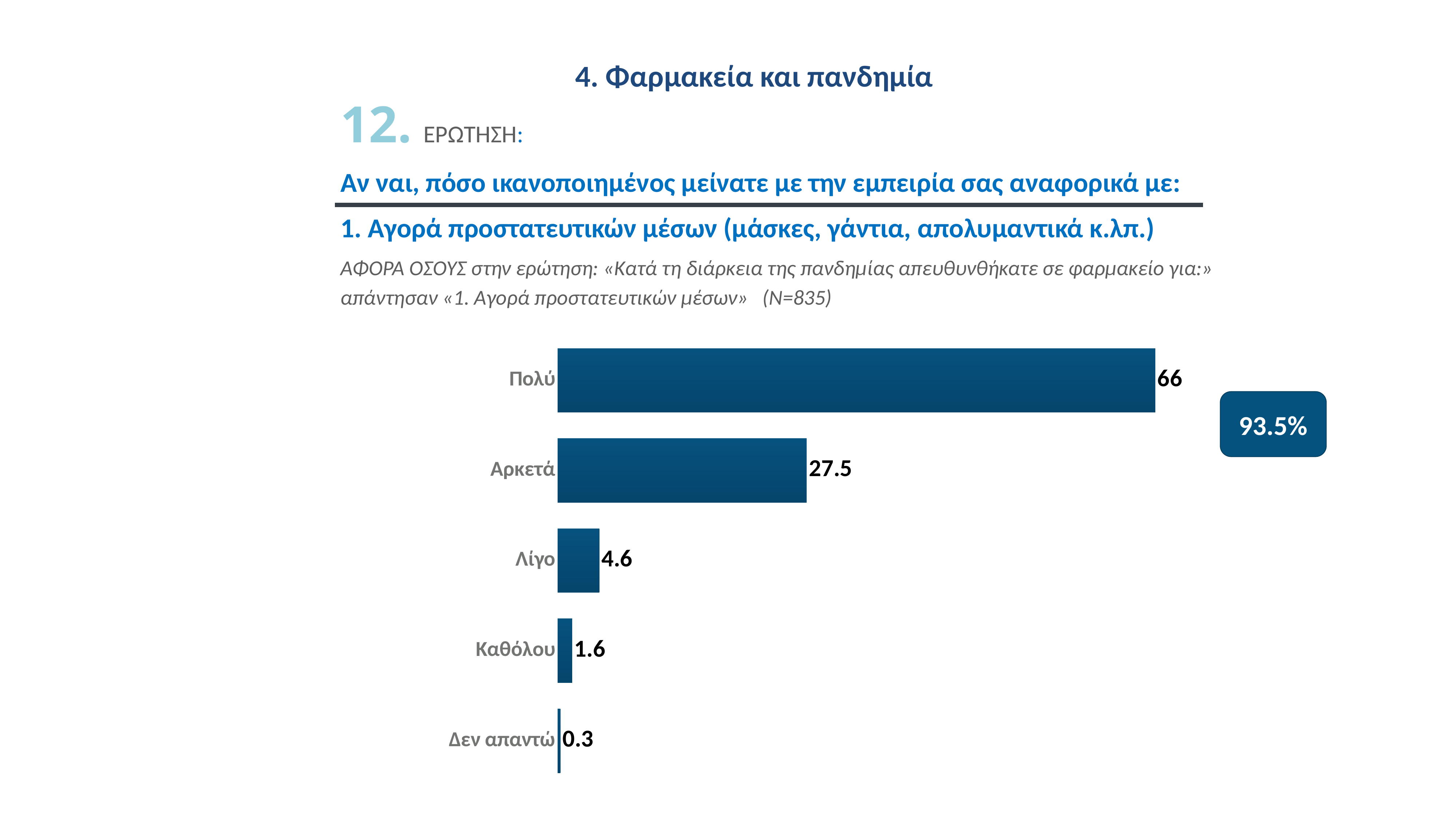
What is the value for Λίγο? 4.6 Which category has the highest value? Πολύ What is the value for Καθόλου? 1.6 How many categories are shown in the chart? 5 Which category has the lowest value? Δεν απαντώ What percentage is shown in the rounded box to the right of the chart? 93.5% What is the value for Δεν απαντώ? 0.3 What kind of chart is shown on the slide? Bar chart What is the value for Πολύ? 66 What is the difference between the values for Πολύ and Αρκετά? 38.5 Which is larger, the value for Λίγο or the value for Καθόλου? Λίγο What is the value for Αρκετά? 27.5